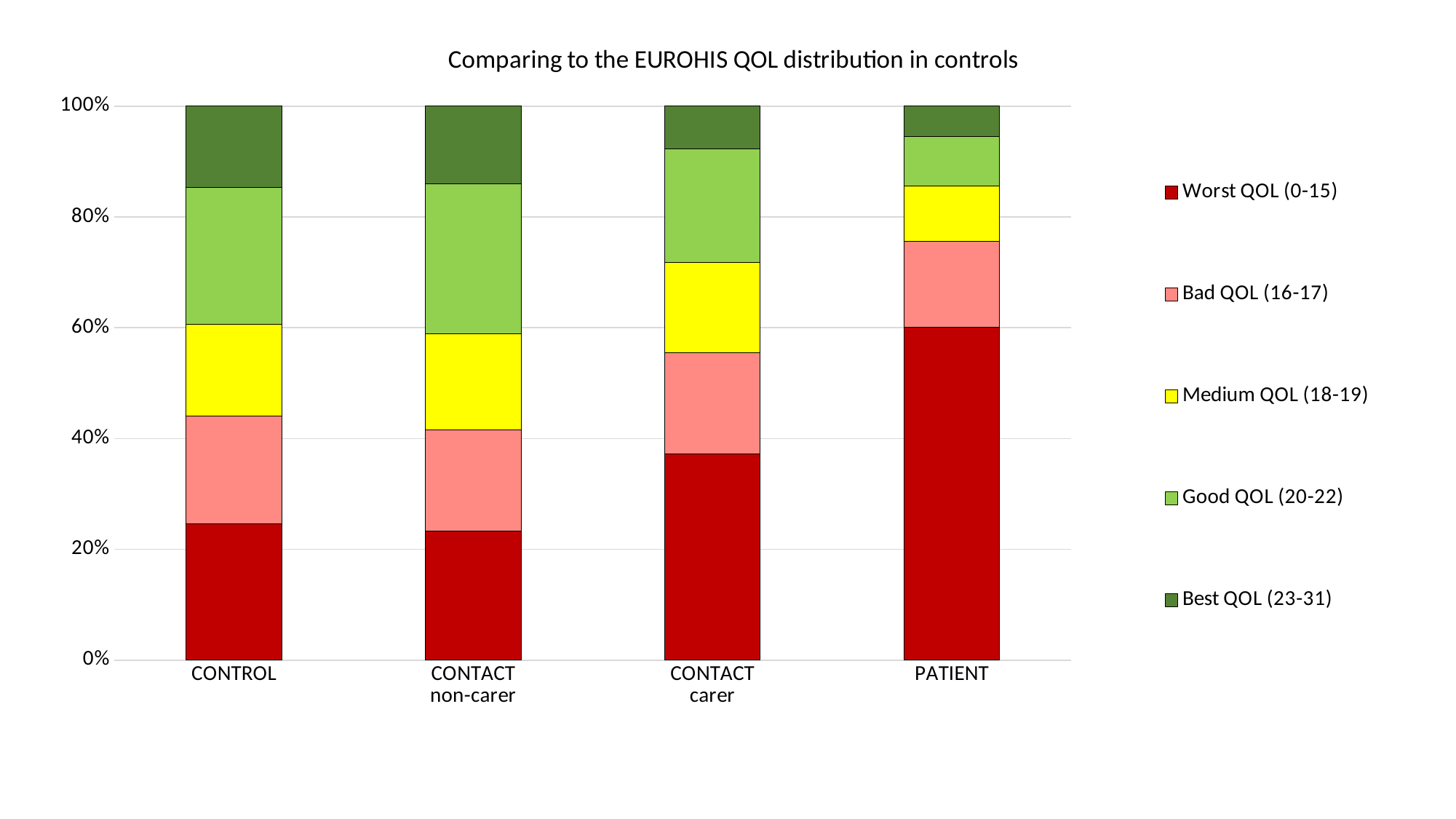
What is the total height of the PATIENT stacked bar? 100% Is the Worst QOL (0-15) share for PATIENT greater or less than 40%? greater How many categories are shown along the x axis? 4 Which category has the largest Worst QOL (0-15) share? PATIENT What is the title of the chart? Comparing to the EUROHIS QOL distribution in controls Is the Worst QOL (0-15) share for CONTACT carer greater or less than 20%? greater Which legend entry is shown in dark red? Worst QOL (0-15) Which has the larger Best QOL (23-31) share, CONTROL or PATIENT? CONTROL Is the Worst QOL (0-15) share for CONTROL greater or less than 40%? less Which has the larger Worst QOL (0-15) share, CONTACT non-carer or CONTACT carer? CONTACT carer What kind of chart is shown on the slide? Stacked bar chart How many series does the legend list? 5